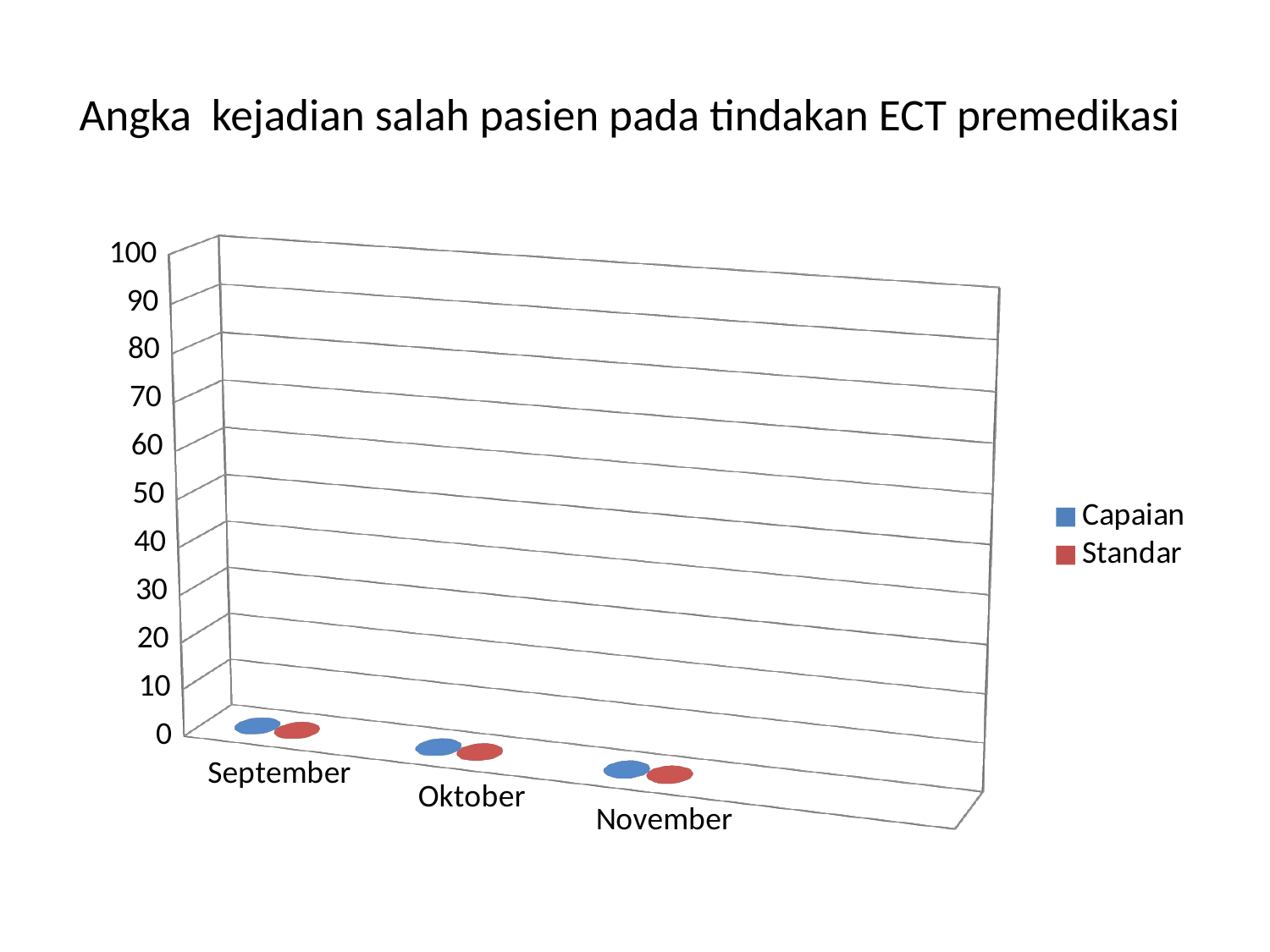
What is the Capaian value for Oktober? 0 How many months are shown on the x axis? 3 Is the Capaian value for November greater or less than 20? less How many series does the legend list? 2 Is the Capaian value for September greater or less than 10? less What are the two series named in the legend? Capaian and Standar Is the Standar value for Oktober greater or less than 10? less What kind of chart is shown on the slide? bar chart What is the Standar value for November? 0 What is the highest value shown on the vertical axis? 100 What is the title of the chart? Angka kejadian salah pasien pada tindakan ECT premedikasi